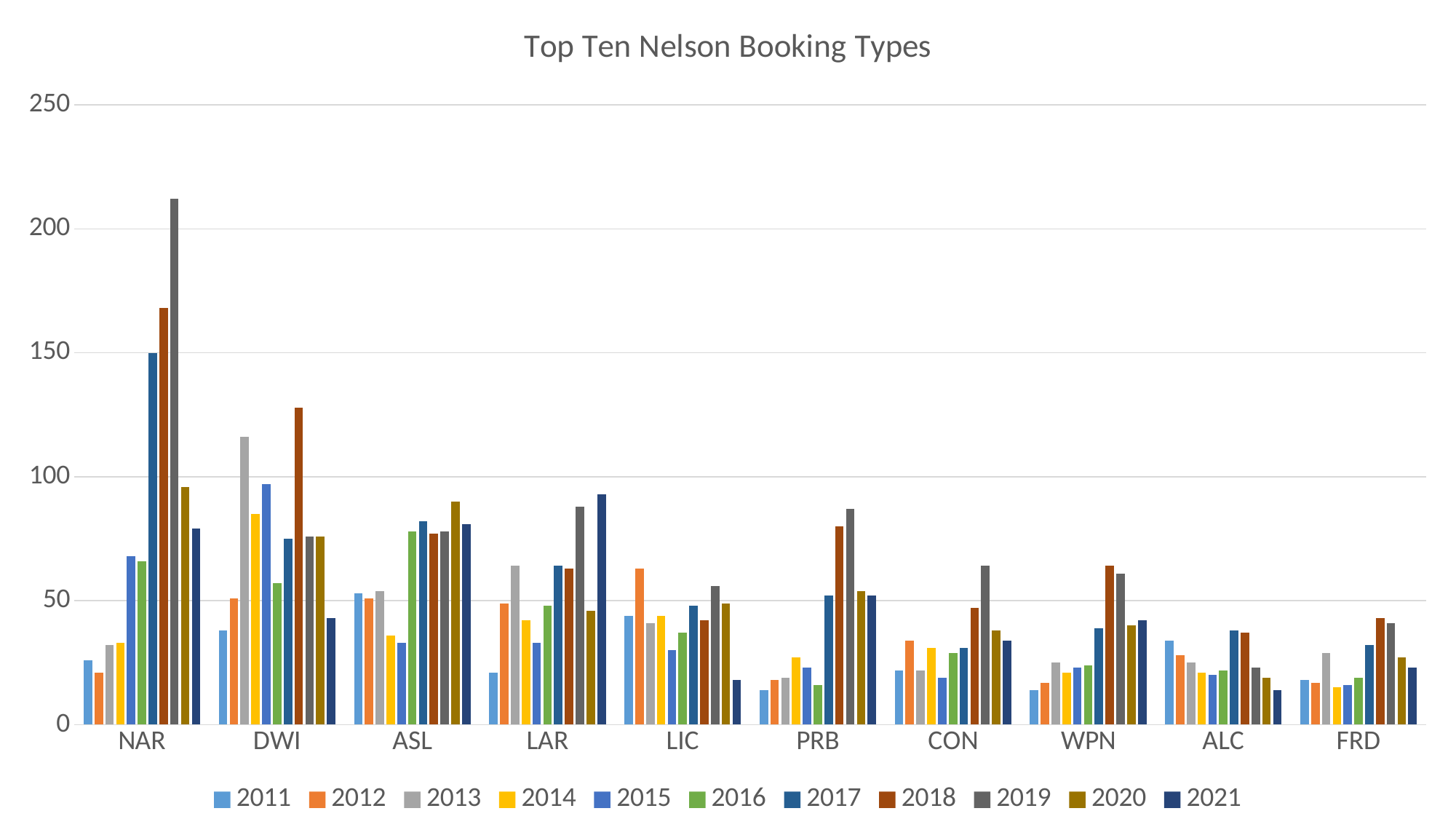
What is the title of the chart? Top Ten Nelson Booking Types For NAR, which year has the highest value? 2019 For DWI, which year has the highest value? 2018 Which is larger: the 2019 value for NAR or the 2018 value for DWI? the 2019 value for NAR For CON, which year has the highest value? 2019 How many series (years) does the legend list? 11 Is the value for LIC in 2021 greater or less than 50? less How many booking type categories are shown on the x axis? 10 Is the value for DWI in 2018 greater or less than 100? greater What type of chart is shown on the slide? bar chart Is the value for NAR in 2019 greater or less than 200? greater